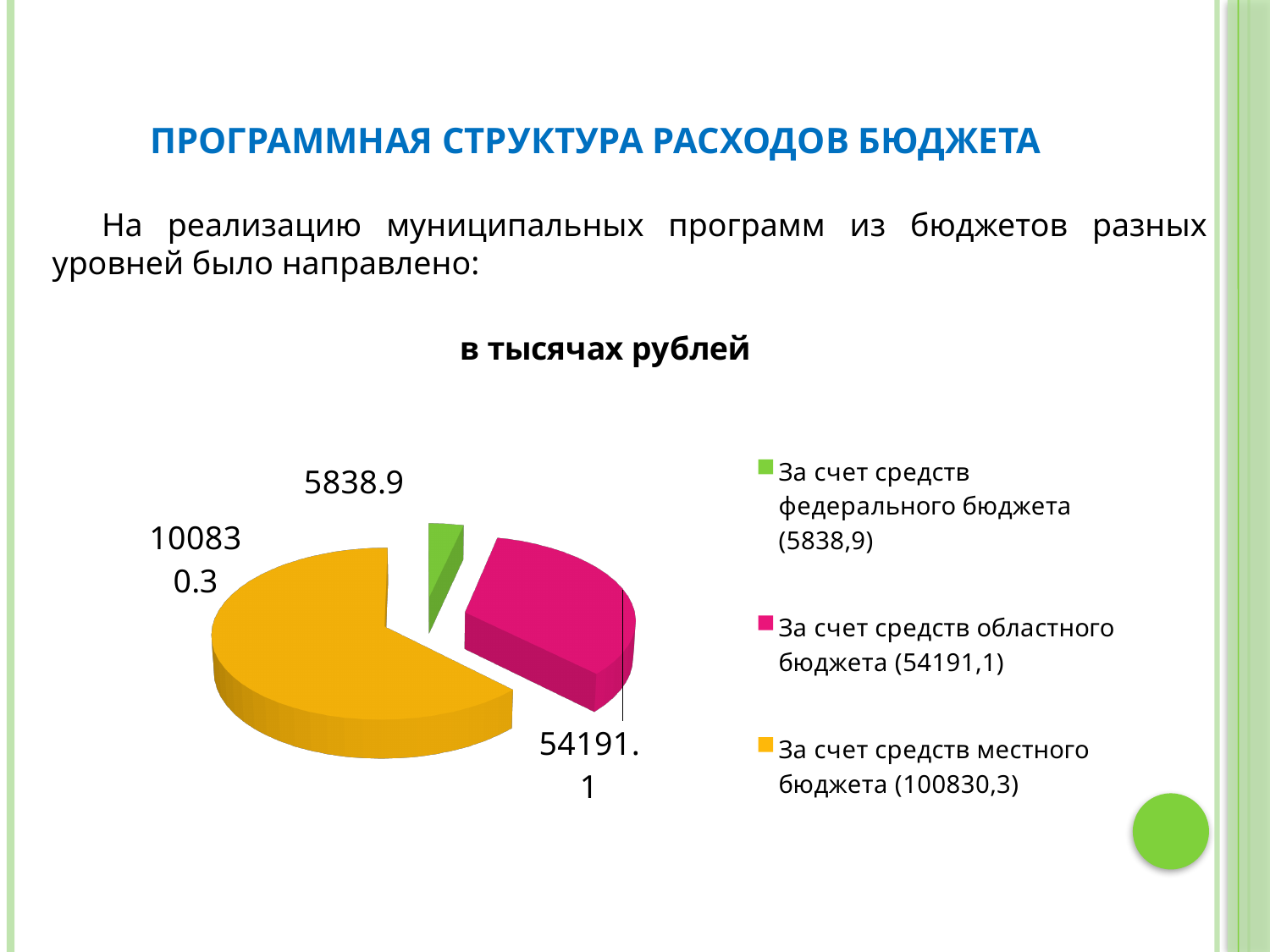
What is the value for funds from the regional budget (За счет средств областного бюджета)? 54191.1 Which budget source has the smallest slice of the pie? За счет средств федерального бюджета What is the difference between the regional budget value and the federal budget value? 48352.2 What is the value for funds from the federal budget (За счет средств федерального бюджета)? 5838.9 What is the difference between the local budget value and the regional budget value? 46639.2 How many slices does the pie chart have? 3 What kind of chart is shown on the slide? Pie chart Which is larger: the regional budget value or the federal budget value? За счет средств областного бюджета Which budget source has the largest slice of the pie? За счет средств местного бюджета What is the value for funds from the local budget (За счет средств местного бюджета)? 100830.3 What is the total of all three values in the pie chart? 160860.3 What is the title of the chart? в тысячах рублей